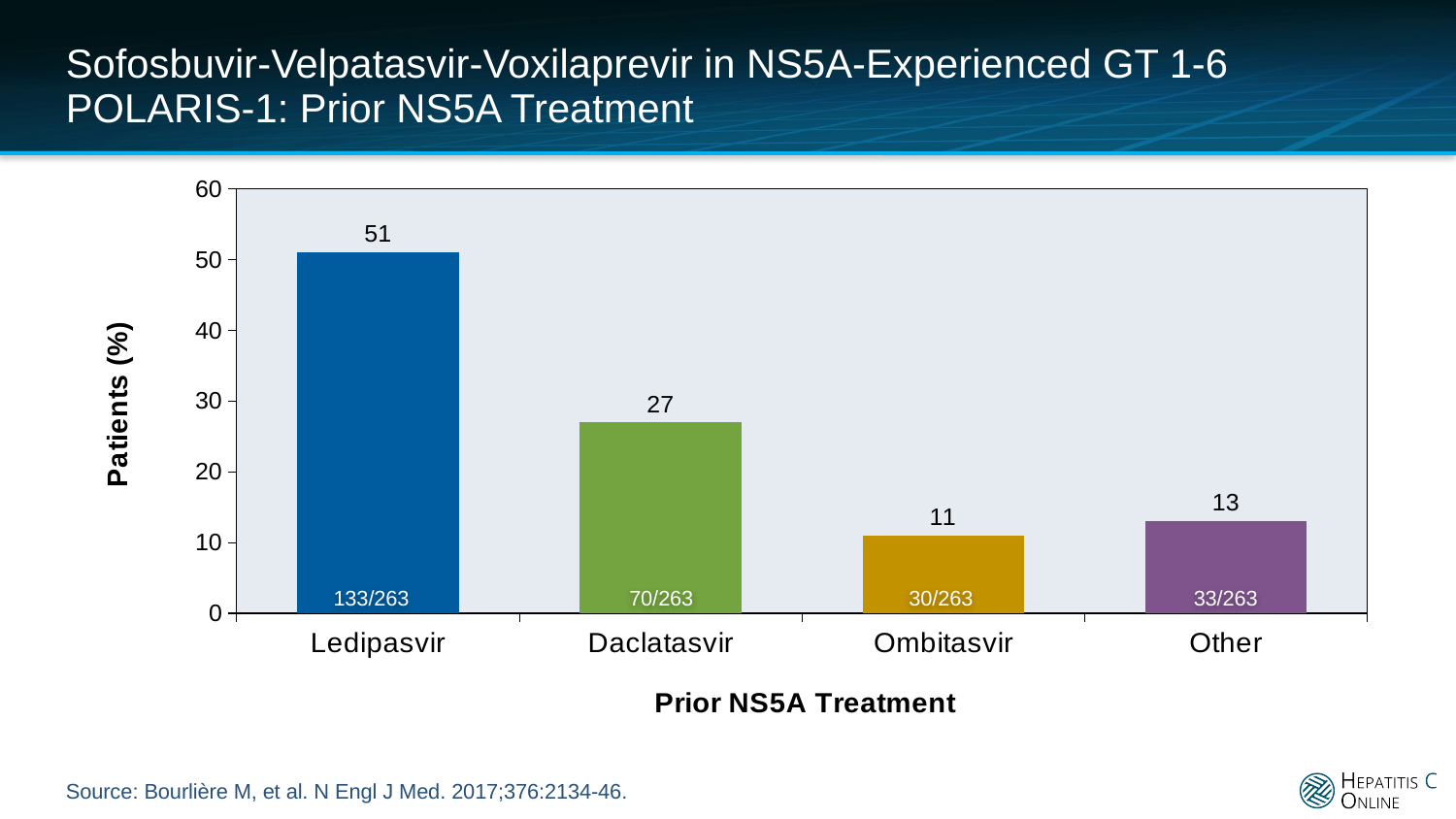
What percentage of patients had prior Ledipasvir treatment? 51 Which prior NS5A treatment category has the lowest percentage of patients? Ombitasvir What is the label of the y-axis? Patients (%) What percentage of patients had prior Ombitasvir treatment? 11 What percentage of patients had prior Daclatasvir treatment? 27 Which prior NS5A treatment category has the highest percentage of patients? Ledipasvir What fraction of patients is shown for the Other category? 33/263 Is the value for Ledipasvir greater or less than 40? greater What is the difference in percentage points between Ledipasvir and Daclatasvir? 24 How many prior NS5A treatment categories are shown on the chart? 4 What kind of chart is shown on the slide? Bar chart Which has a higher percentage of patients, Daclatasvir or Other? Daclatasvir